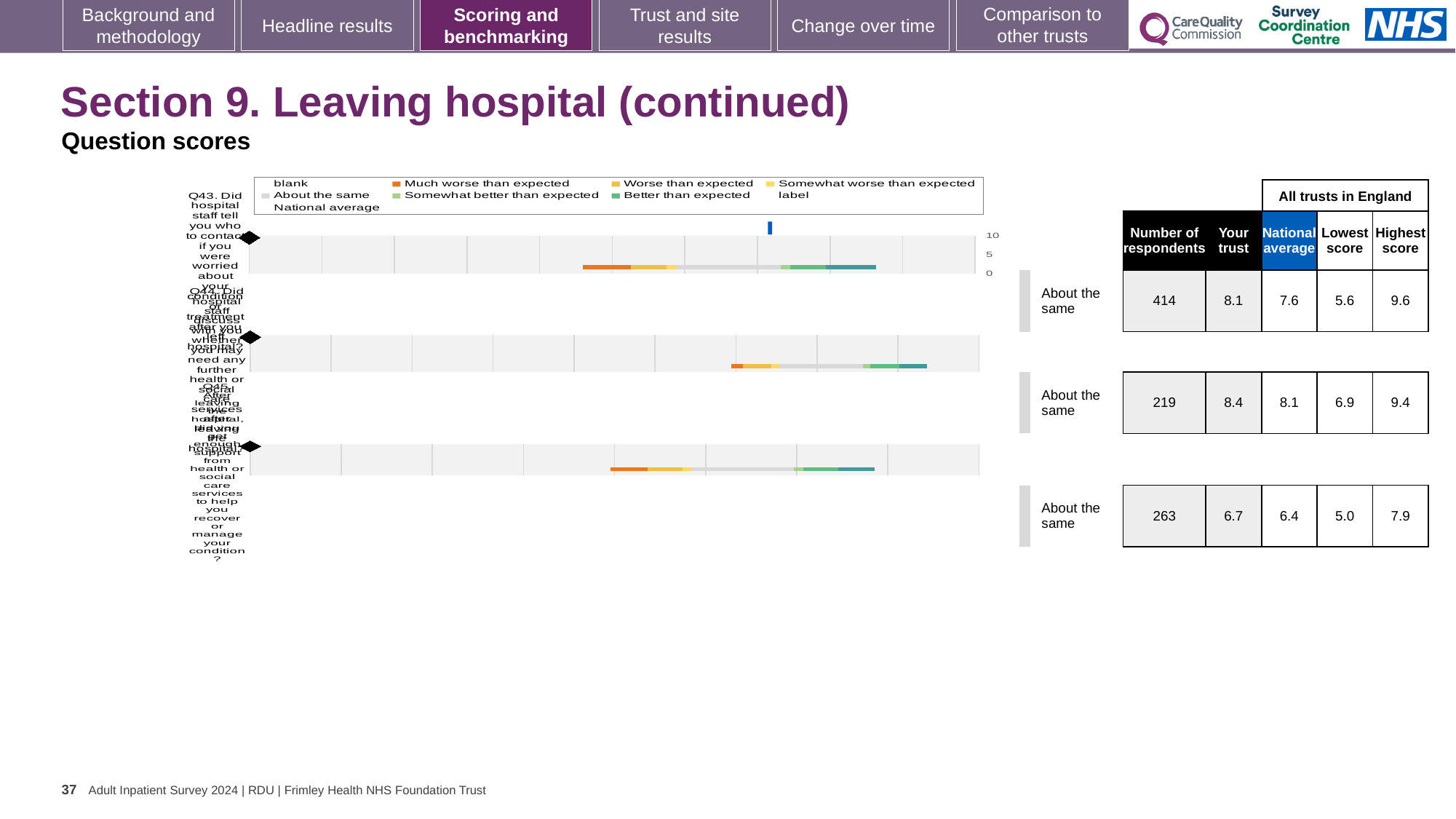
What is the highest score among all trusts in England for Q45? 7.9 How many respondents answered Q44? 219 Which question has the highest 'Your trust' score? Q44 How many questions (Q43, Q44, Q45) are plotted in the chart? 3 Which question has the lowest 'Your trust' score? Q45 What benchmark label is shown for Q43? About the same What is the national average score for Q45? 6.4 How many entries does the chart legend list? 9 What is the 'Your trust' score for Q43? 8.1 For Q44, which is larger: the 'Your trust' score or the national average? Your trust What is the difference between the 'Your trust' score and the national average for Q43? 0.5 What kind of chart is shown on the slide? bar chart